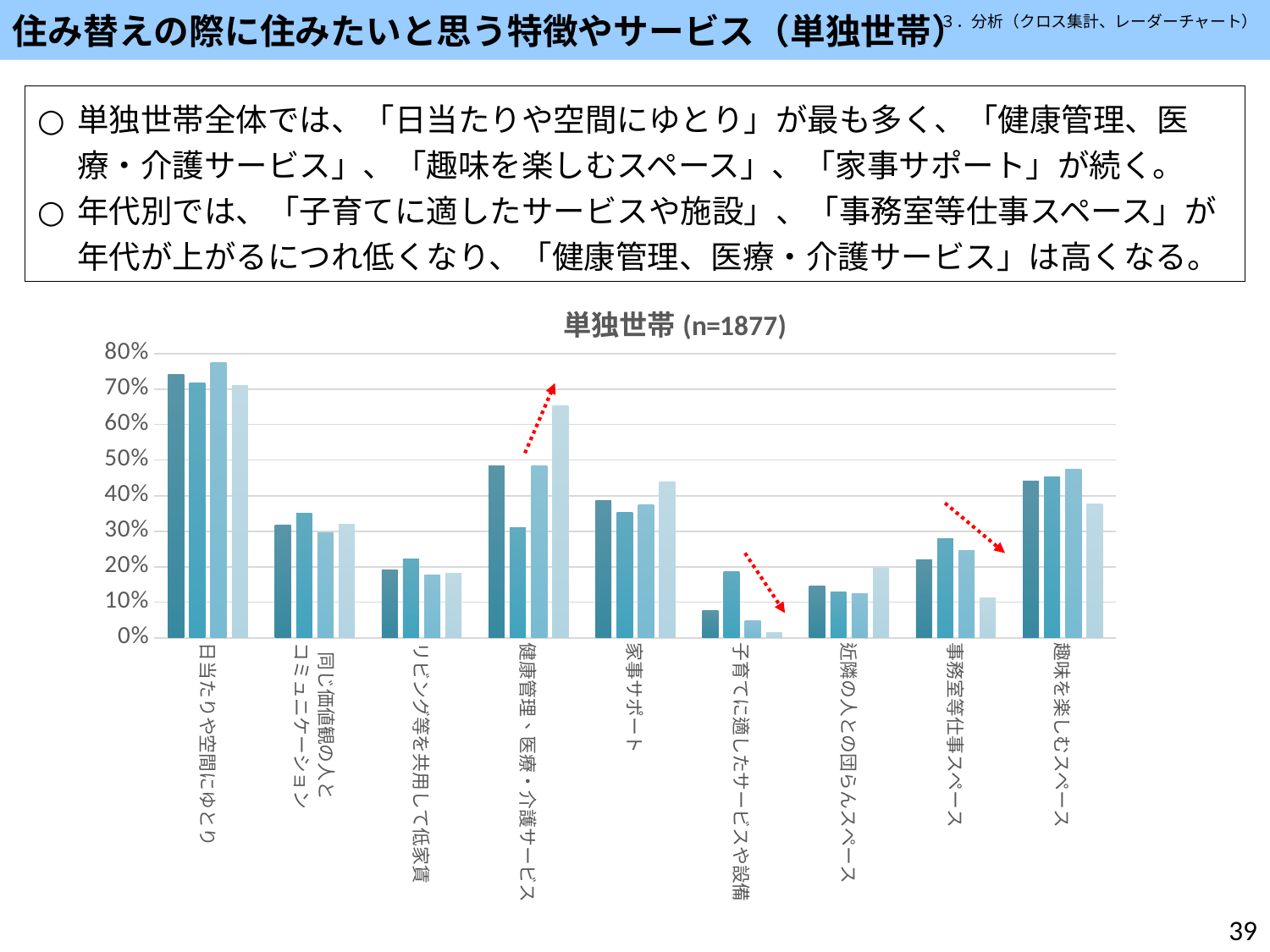
Is the value of the fourth (rightmost) bar for 趣味を楽しむスペース greater or less than 40%? less How many categories are shown along the x axis of the chart? 9 Is the value of the first (leftmost) bar for 日当たりや空間にゆとり greater or less than 70%? greater Which category has the larger first (leftmost) bar: 家事サポート or 近隣の人との団らんスペース? 家事サポート Which category contains the shortest bar in the chart? 子育てに適したサービスや設備 What is the title of the chart? 単独世帯 (n=1877) Which category has the larger fourth (rightmost) bar: 健康管理、医療・介護サービス or 家事サポート? 健康管理、医療・介護サービス Is the value of the fourth (rightmost) bar for 健康管理、医療・介護サービス greater or less than 60%? greater Which category contains the tallest bar in the chart? 日当たりや空間にゆとり What kind of chart is shown on the slide? bar chart How many bars are plotted for each category in the chart? 4